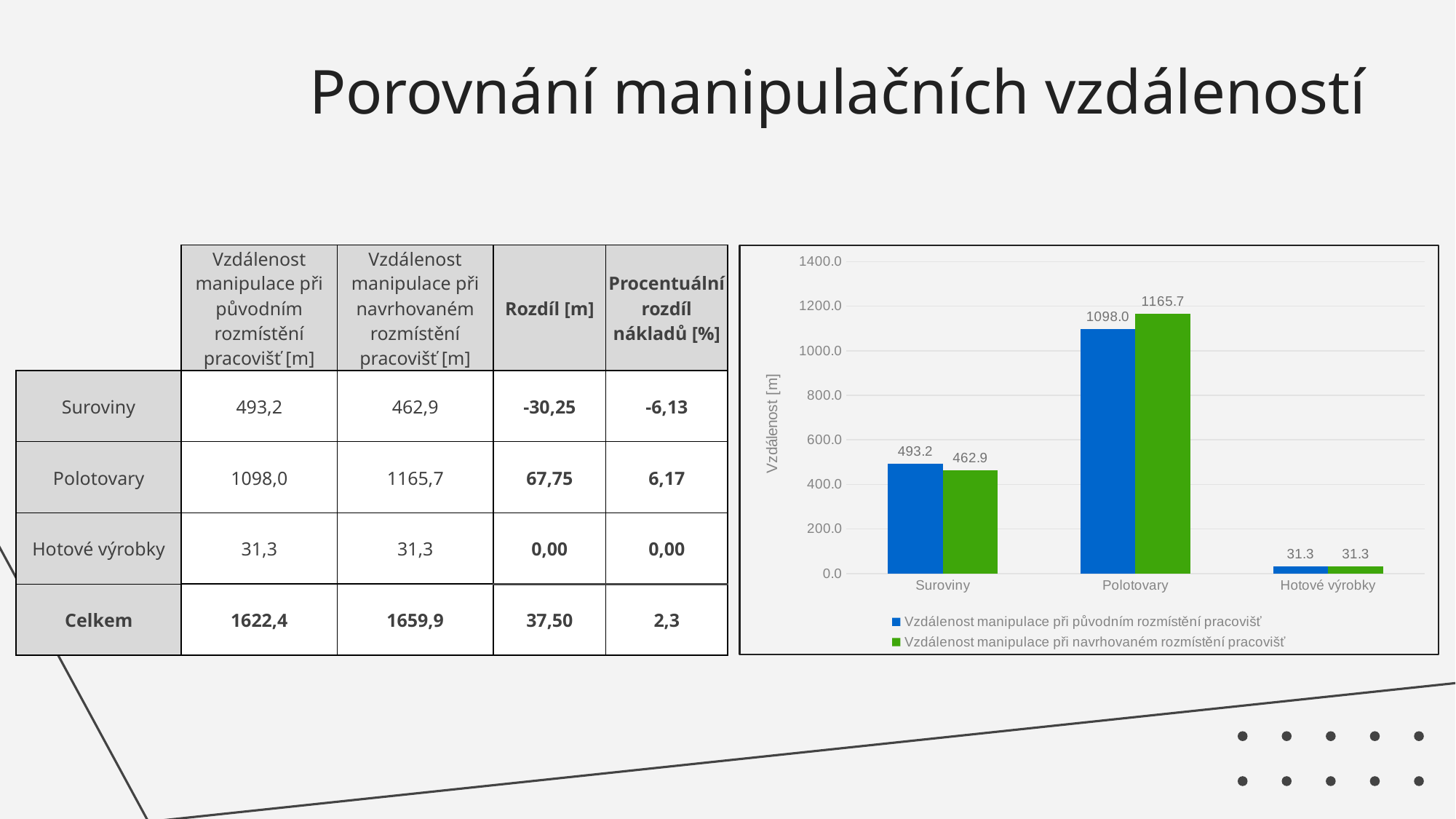
How many categories are shown on the x axis of the chart? 3 What is the difference between the two series' values for Polotovary? 67.7 What kind of chart is shown on the slide? bar chart How many series does the chart legend list? 2 What is the value for Suroviny in the series 'Vzdálenost manipulace při původním rozmístění pracovišť'? 493.2 Which category has the highest value in the series 'Vzdálenost manipulace při původním rozmístění pracovišť'? Polotovary Is the value for Polotovary in the series 'Vzdálenost manipulace při původním rozmístění pracovišť' greater or less than 1000.0? greater For Suroviny, which series has the larger value: 'Vzdálenost manipulace při původním rozmístění pracovišť' or 'Vzdálenost manipulace při navrhovaném rozmístění pracovišť'? Vzdálenost manipulace při původním rozmístění pracovišť What is the label of the vertical axis of the chart? Vzdálenost [m] What is the value for Polotovary in the series 'Vzdálenost manipulace při navrhovaném rozmístění pracovišť'? 1165.7 What is the value for Hotové výrobky in the series 'Vzdálenost manipulace při původním rozmístění pracovišť'? 31.3 Which category has the lowest value in the series 'Vzdálenost manipulace při navrhovaném rozmístění pracovišť'? Hotové výrobky